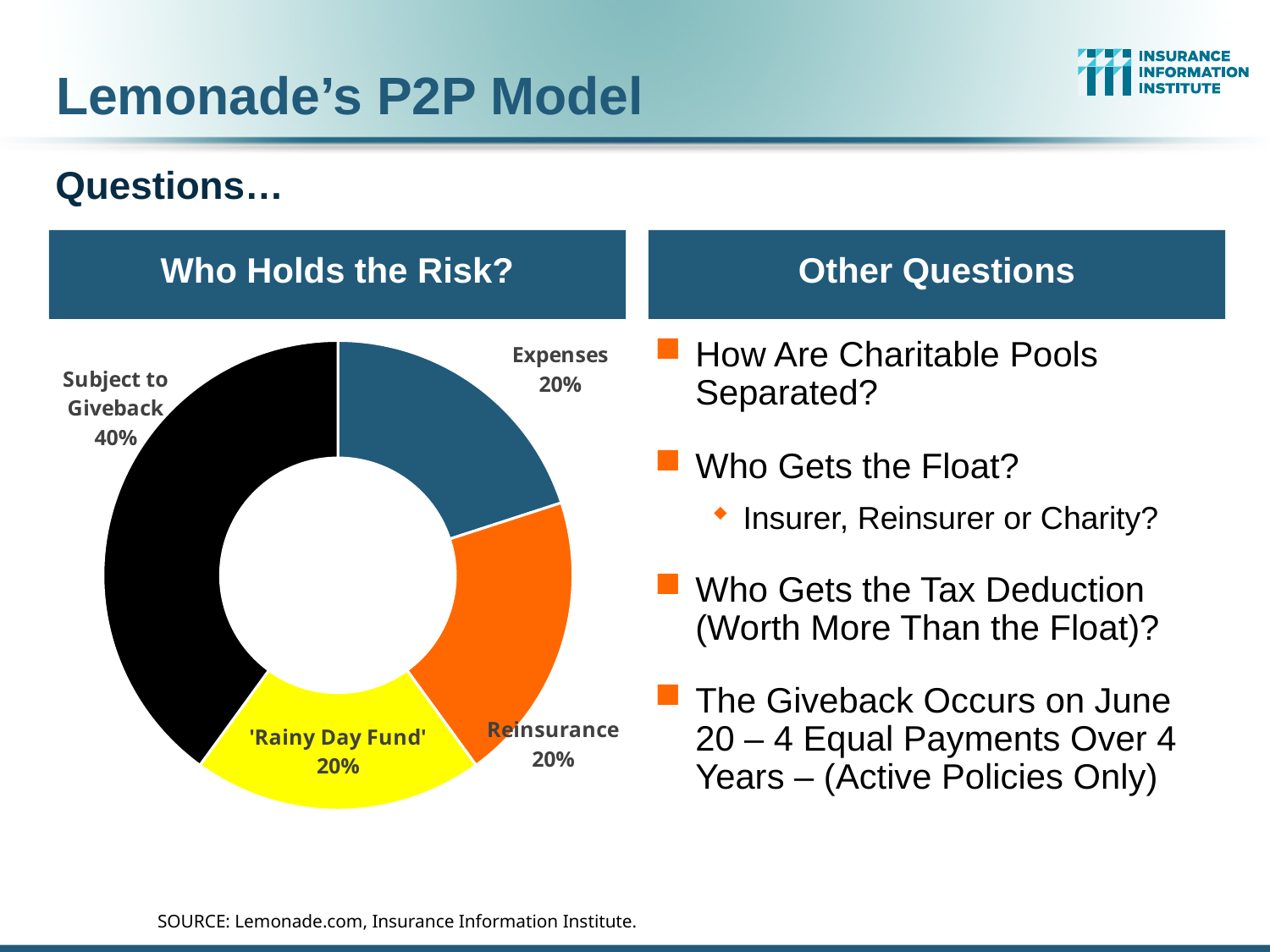
What colour is the Subject to Giveback slice in the "Who Holds the Risk?" chart? Black What colour is the 'Rainy Day Fund' slice in the "Who Holds the Risk?" chart? Yellow Which slice of the "Who Holds the Risk?" chart is the largest? Subject to Giveback What share of the "Who Holds the Risk?" chart is labelled 'Rainy Day Fund'? 20% In the "Who Holds the Risk?" chart, which is larger: Subject to Giveback or Reinsurance? Subject to Giveback What share of the "Who Holds the Risk?" chart is labelled Reinsurance? 20% In the "Who Holds the Risk?" chart, how much larger is the Subject to Giveback share than the Expenses share? 20 percentage points In the "Who Holds the Risk?" chart, what is the combined share of Expenses, Reinsurance and 'Rainy Day Fund'? 60% What share of the "Who Holds the Risk?" chart is labelled Expenses? 20% How many slices does the "Who Holds the Risk?" chart have? 4 What share of the "Who Holds the Risk?" chart is labelled Subject to Giveback? 40% What kind of chart is shown under the heading "Who Holds the Risk?"? Doughnut (pie) chart